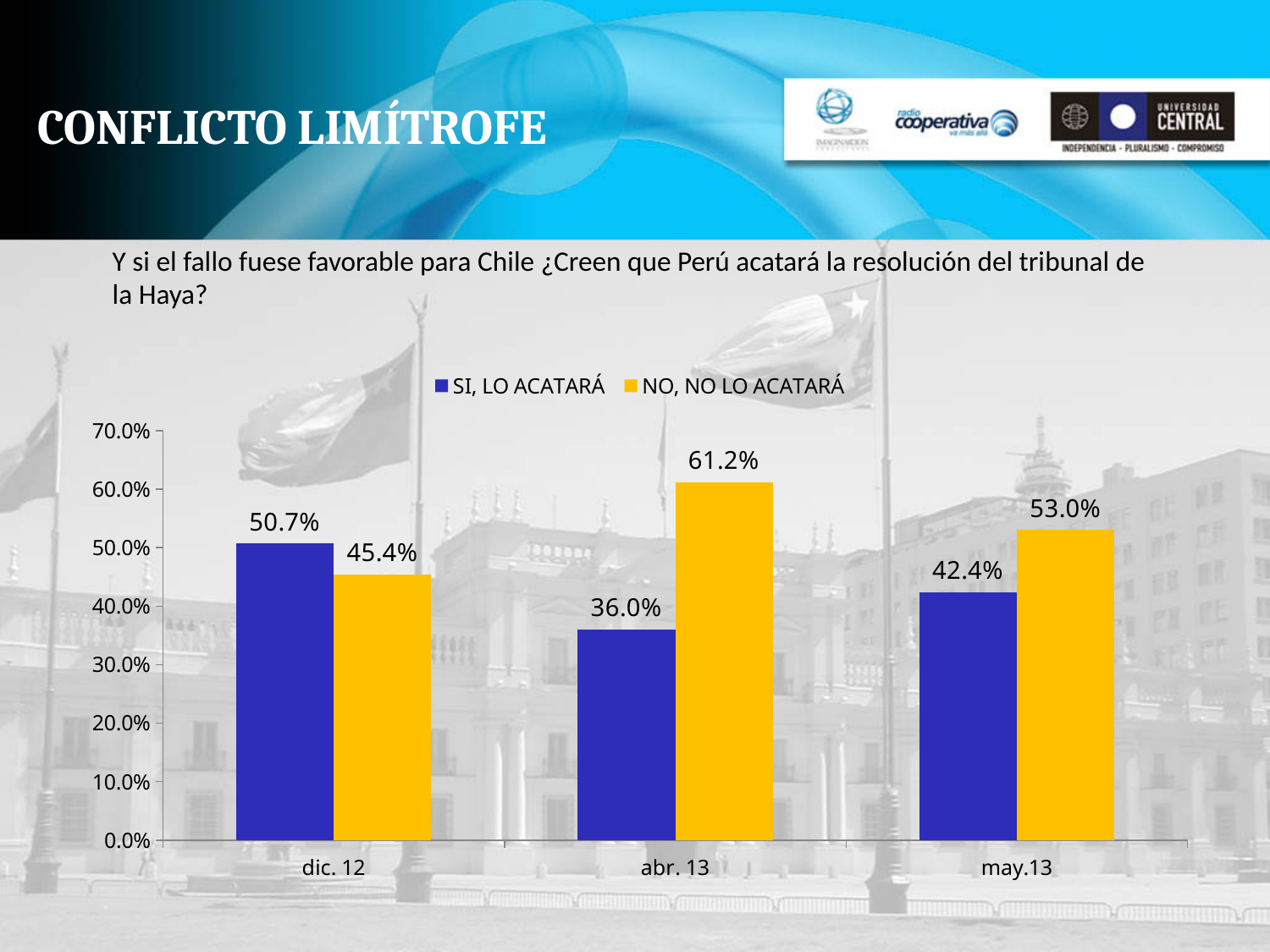
How many series does the legend list? 2 What is the value for "SI, LO ACATARÁ" in may.13? 42.4% In which period is the "NO, NO LO ACATARÁ" value highest? abr. 13 What is the value for "NO, NO LO ACATARÁ" in abr. 13? 61.2% What kind of chart is shown? bar chart Is the value for "NO, NO LO ACATARÁ" in may.13 greater or less than 50.0%? greater How many periods are shown on the x axis? 3 In which period is the "SI, LO ACATARÁ" value lowest? abr. 13 What is the value for "SI, LO ACATARÁ" in dic. 12? 50.7% In dic. 12, which is larger: "SI, LO ACATARÁ" or "NO, NO LO ACATARÁ"? SI, LO ACATARÁ What is the difference between "NO, NO LO ACATARÁ" and "SI, LO ACATARÁ" in abr. 13? 25.2% Which colour represents "NO, NO LO ACATARÁ" in the chart? yellow